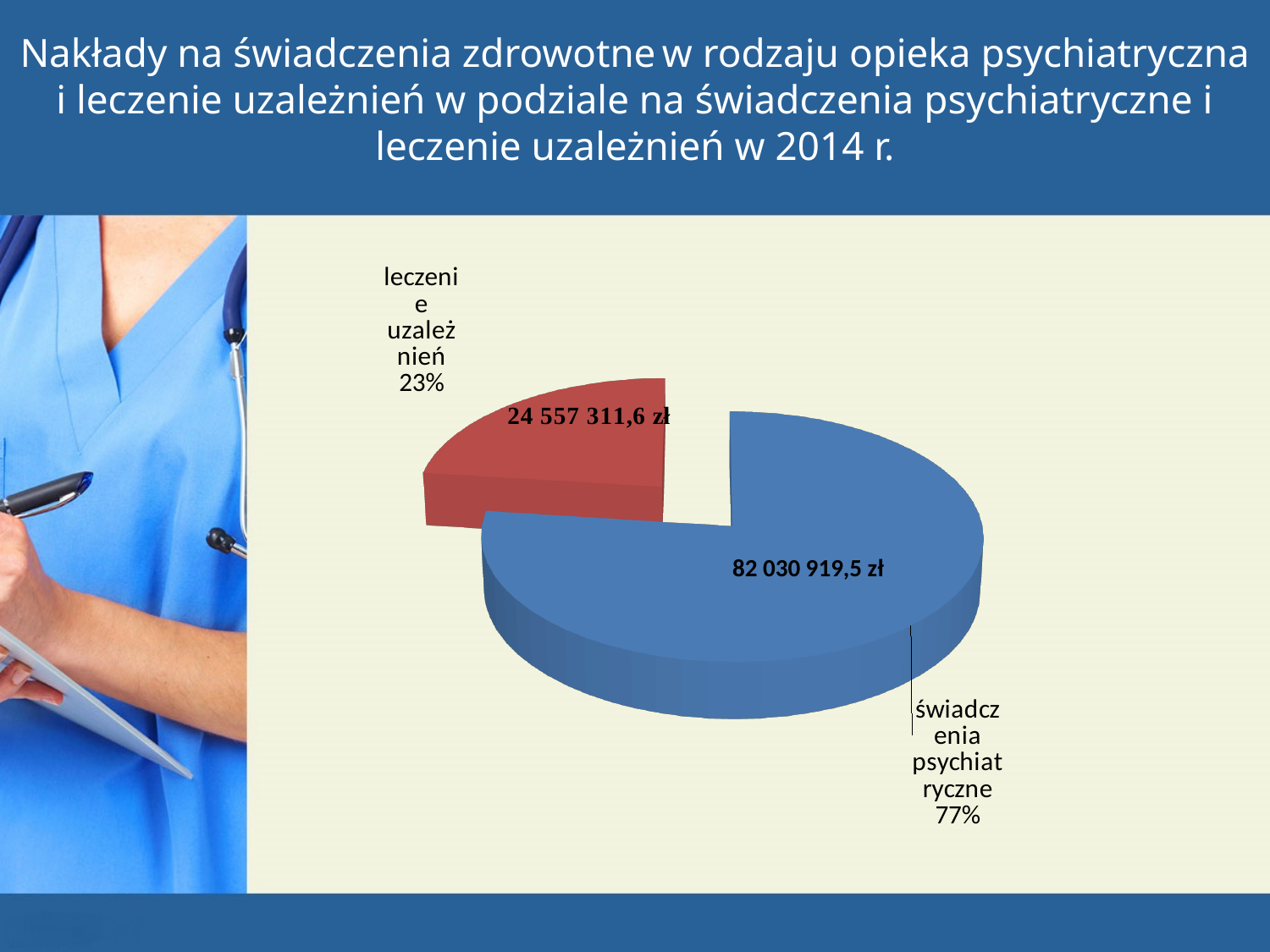
What is the difference between the value for świadczenia psychiatryczne and the value for leczenie uzależnień? 57 473 607,9 zł Which category has the smallest slice of the pie? leczenie uzależnień What share of the pie does świadczenia psychiatryczne represent? 77% Which is larger, the value for świadczenia psychiatryczne or for leczenie uzależnień? świadczenia psychiatryczne What is the total of the two values shown in the pie chart? 106 588 231,1 zł How many slices does the pie chart have? 2 What kind of chart is shown on the slide? pie chart What is the value shown for świadczenia psychiatryczne? 82 030 919,5 zł What share of the pie does leczenie uzależnień represent? 23% What is the value shown for leczenie uzależnień? 24 557 311,6 zł What colour is the slice for leczenie uzależnień? red Which category has the largest slice of the pie? świadczenia psychiatryczne